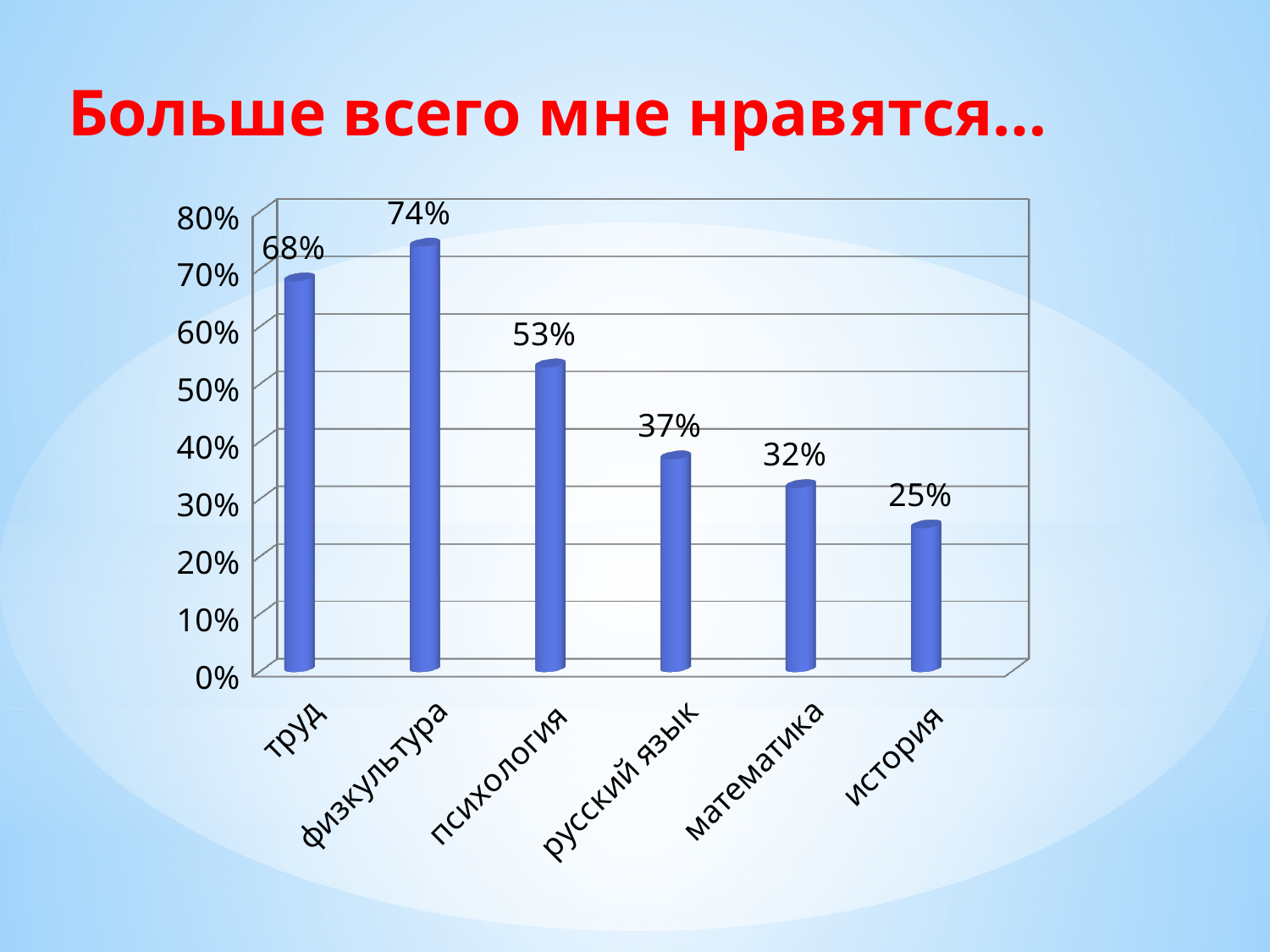
What is the title of the slide? Больше всего мне нравятся… What is the value for труд? 68% What is the difference between the values for русский язык and математика? 5% What kind of chart is shown on the slide? bar chart Which category has the highest value? физкультура What is the value for психология? 53% Which is larger, the value for психология or the value for русский язык? психология Which category has the lowest value? история What is the value for физкультура? 74% What is the difference between the values for физкультура and труд? 6% What is the value for история? 25% How many categories are shown on the chart? 6